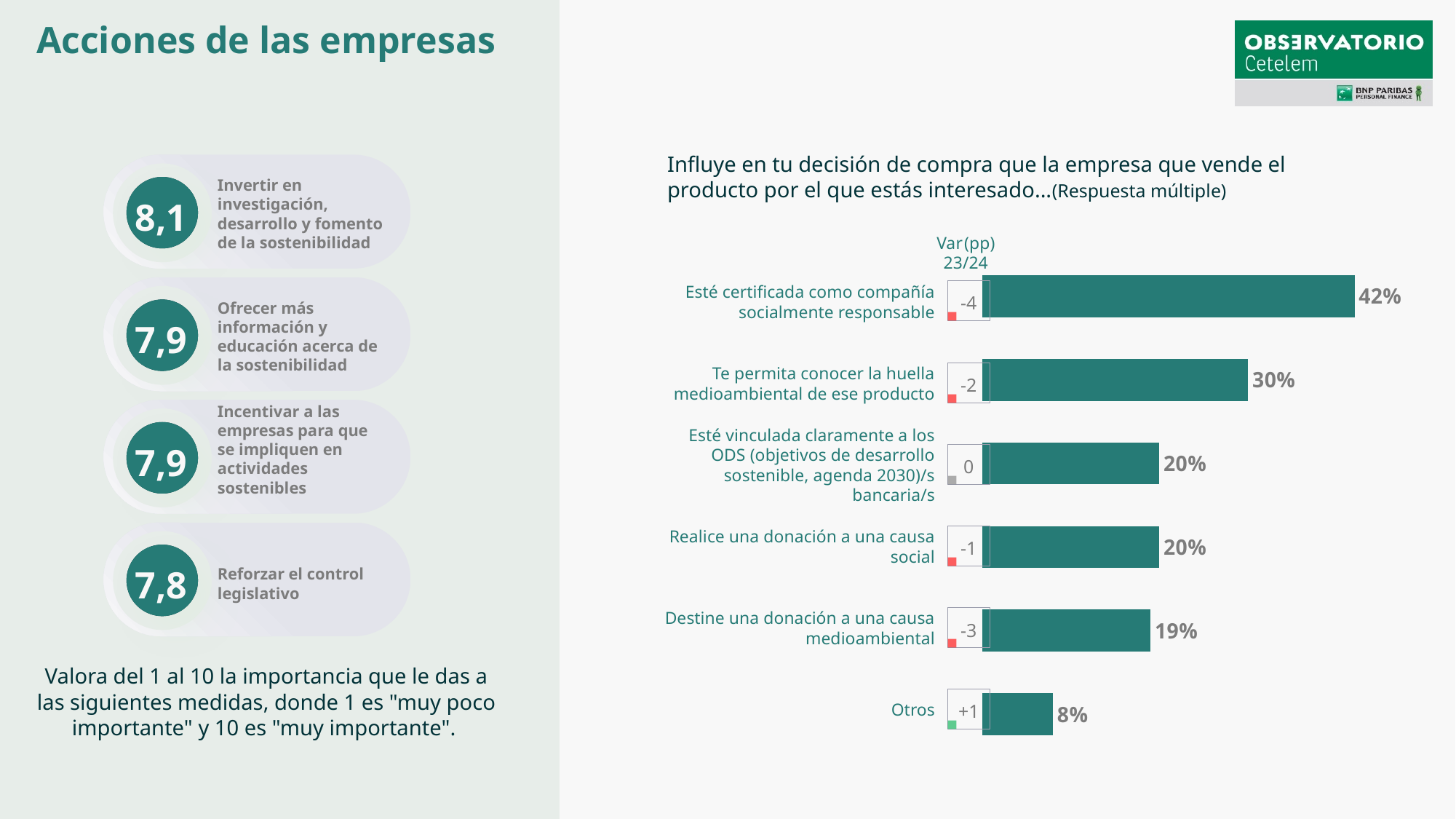
Which category has the highest value in the bar chart? Esté certificada como compañía socialmente responsable What kind of chart is shown on the right side of the slide? Bar chart Which category has the lowest value in the bar chart? Otros What is the difference in percentage points between "Esté certificada como compañía socialmente responsable" and "Te permita conocer la huella medioambiental de ese producto"? 12 What is the value for "Otros"? 8% What is the Var(pp) 23/24 value shown for "Otros"? +1 How many categories are shown in the bar chart? 6 Which two categories in the bar chart both have a value of 20%? Esté vinculada claramente a los ODS (objetivos de desarrollo sostenible, agenda 2030)/s bancaria/s; Realice una donación a una causa social Which is larger: the value for "Destine una donación a una causa medioambiental" or the value for "Otros"? Destine una donación a una causa medioambiental What percentage of respondents said it influences their purchase decision that the company is certified as socially responsible ("Esté certificada como compañía socialmente responsable")? 42% What is the Var(pp) 23/24 value shown for "Esté certificada como compañía socialmente responsable"? -4 What is the value for "Te permita conocer la huella medioambiental de ese producto"? 30%